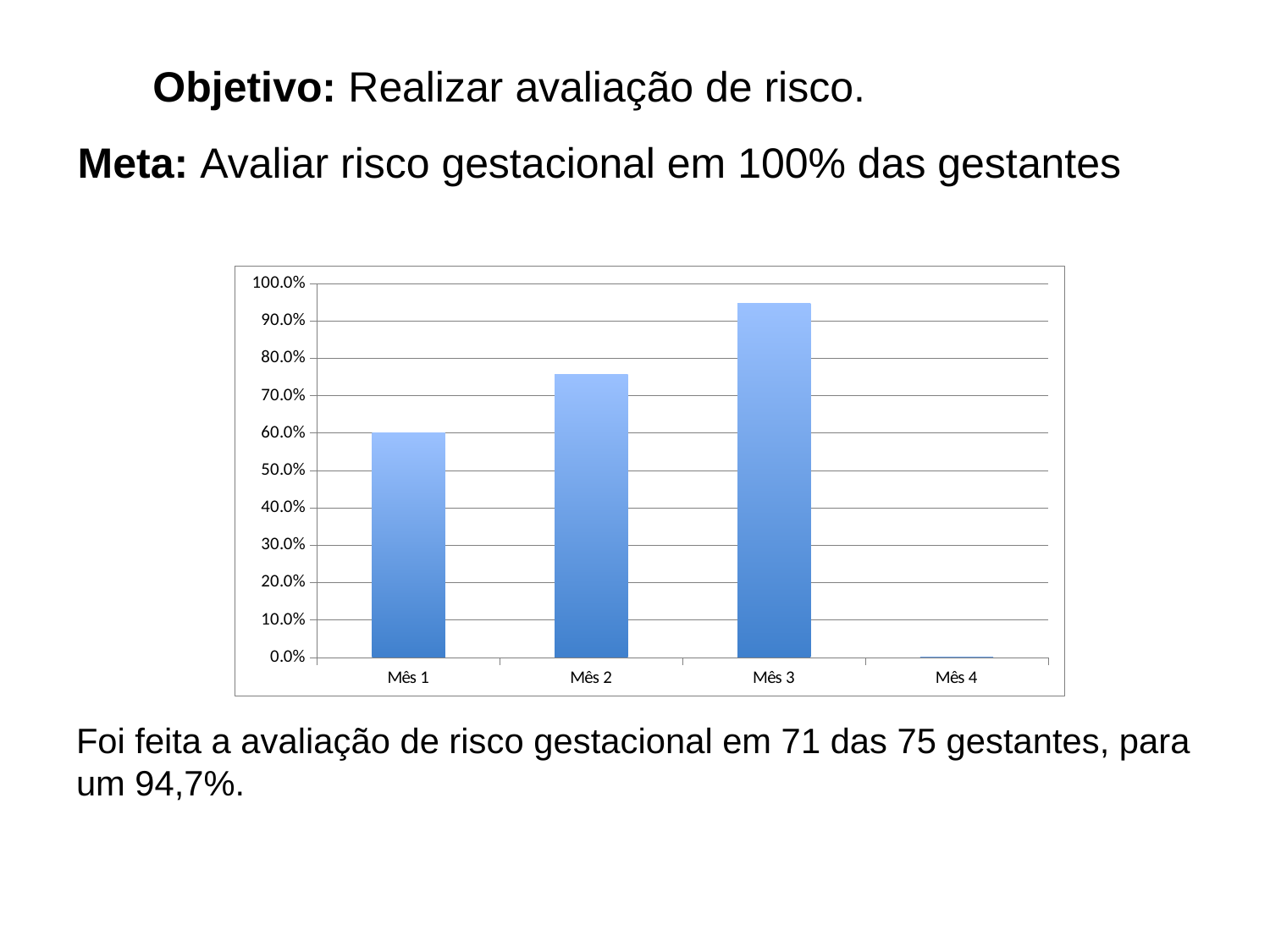
Do the values rise or fall from Mês 1 to Mês 3? rise Is the value for Mês 2 greater or less than 80.0%? less Is the value for Mês 2 greater or less than 70.0%? greater What type of chart is shown on the slide? bar chart What is the value for Mês 1 in the chart? 60.0% What is the maximum value shown on the y axis of the chart? 100.0% Which month has the highest value in the chart? Mês 3 How many categories are shown on the x axis of the chart? 4 Is the value for Mês 3 greater or less than 90.0%? greater Which is larger, the value for Mês 2 or the value for Mês 3? Mês 3 Which month has the lowest value in the chart? Mês 4